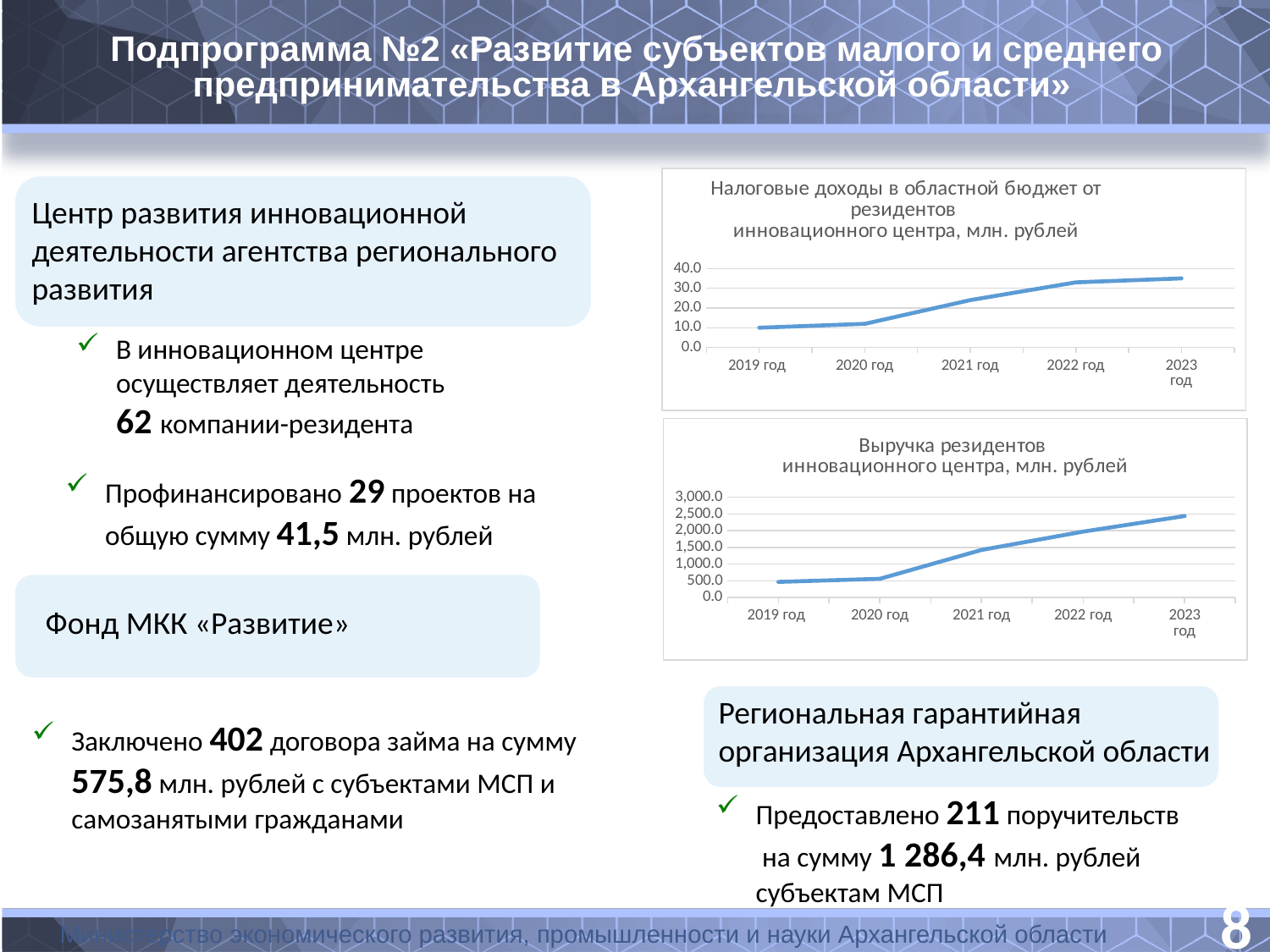
What kind of chart is the bottom chart, 'Выручка резидентов инновационного центра'? line chart In the bottom chart, 'Выручка резидентов инновационного центра', which year has the lowest value? 2019 год In the bottom chart, 'Выручка резидентов инновационного центра', do the values rise or fall from 2019 год to 2023 год? rise How many points are plotted in the bottom chart, 'Выручка резидентов инновационного центра'? 5 What kind of chart is the top chart, 'Налоговые доходы в областной бюджет от резидентов инновационного центра'? line chart In the top chart, 'Налоговые доходы в областной бюджет', which year has the highest value? 2023 год In the top chart, 'Налоговые доходы в областной бюджет', do the values rise or fall from 2019 год to 2023 год? rise What unit is stated in the title of the top chart, 'Налоговые доходы в областной бюджет от резидентов инновационного центра'? млн. рублей How many years are plotted on the x axis of the top chart, 'Налоговые доходы в областной бюджет'? 5 In the bottom chart, 'Выручка резидентов инновационного центра', is the value for 2023 год greater or less than 2,000.0? greater In the top chart, 'Налоговые доходы в областной бюджет', is the value for 2021 год greater or less than 20.0? greater In the bottom chart, 'Выручка резидентов инновационного центра', which is larger: the value for 2020 год or the value for 2022 год? 2022 год